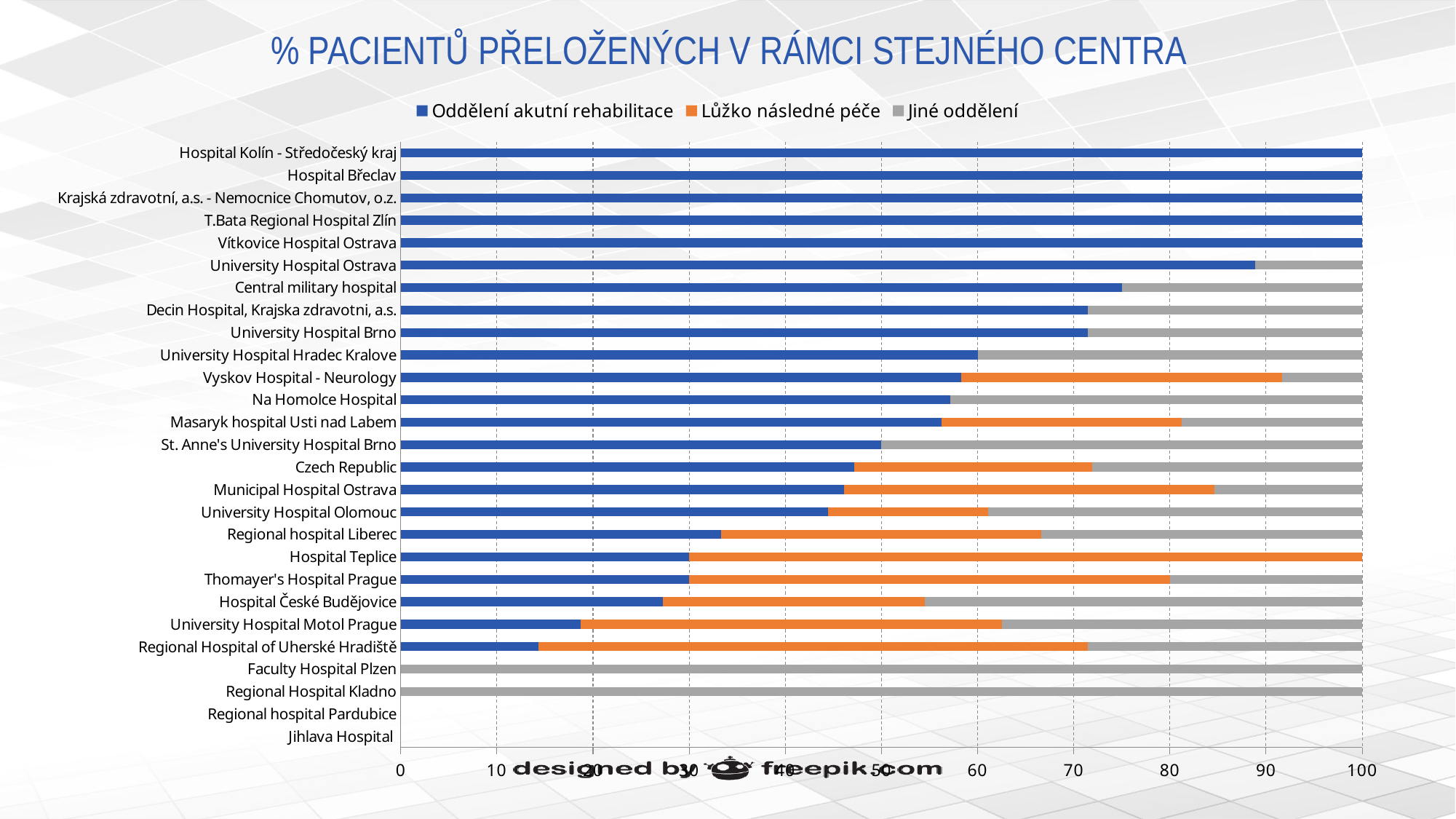
What is the value of Jiné oddělení for Faculty Hospital Plzen? 100 What is the total of the stacked bar for Hospital Teplice? 100 Is the Oddělení akutní rehabilitace value for University Hospital Ostrava greater or less than 80? greater Is the Oddělení akutní rehabilitace value for Regional Hospital of Uherské Hradiště greater or less than 20? less How many categories (hospitals) are listed on the vertical axis? 27 What is the value of Oddělení akutní rehabilitace for Hospital Kolín - Středočeský kraj? 100 Is the Oddělení akutní rehabilitace value for Czech Republic greater or less than 50? less Which has a larger Oddělení akutní rehabilitace value: Vyskov Hospital - Neurology or University Hospital Motol Prague? Vyskov Hospital - Neurology How many series does the legend list? 3 Which colour represents Lůžko následné péče in the legend? orange Which has a larger Oddělení akutní rehabilitace value: Central military hospital or University Hospital Hradec Kralove? Central military hospital What kind of chart is shown on the slide? bar chart